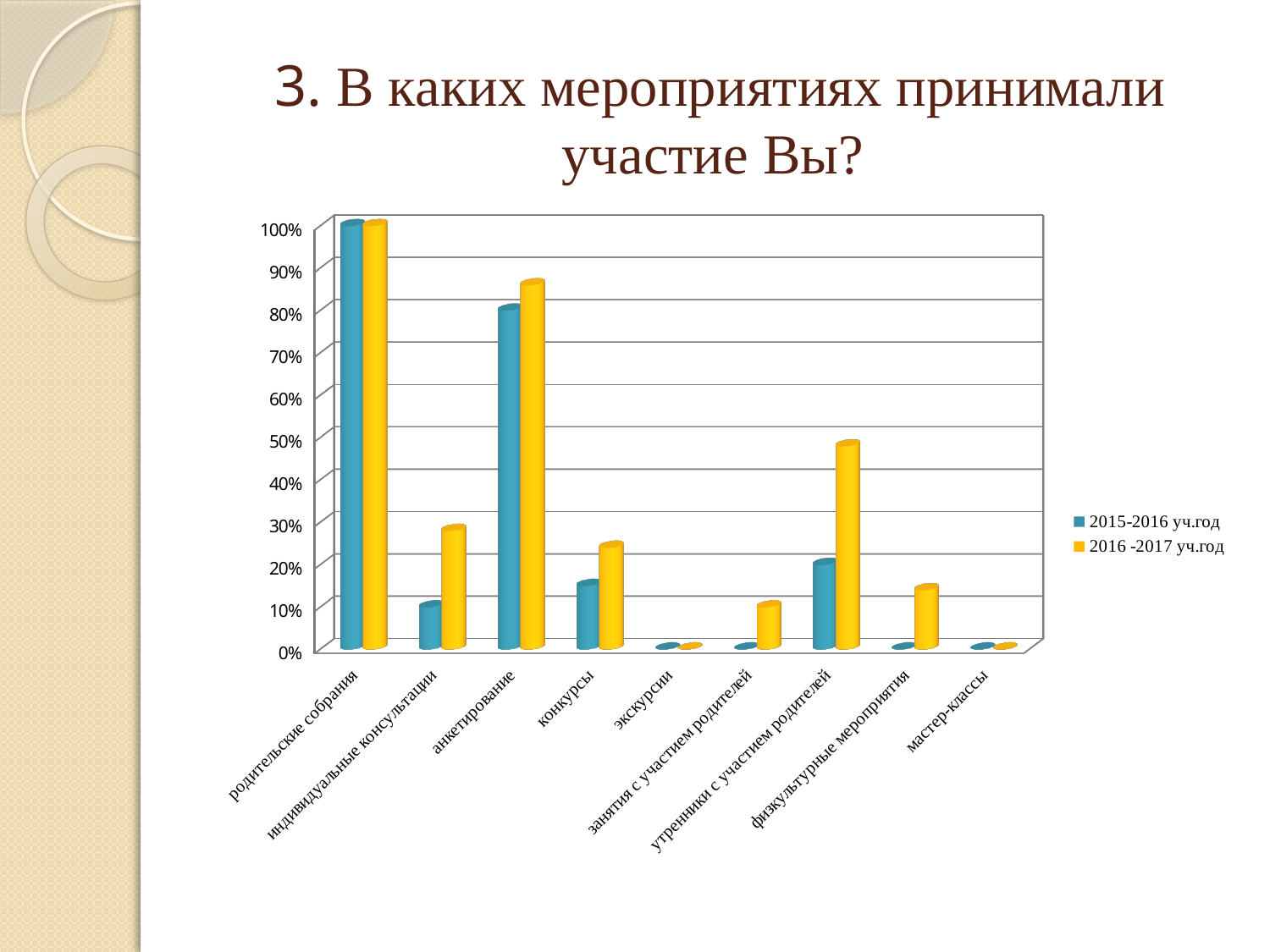
Is the value for анкетирование in the 2016 -2017 уч.год series greater or less than 80%? greater Is the value for утренники с участием родителей in the 2016 -2017 уч.год series greater or less than 40%? greater For утренники с участием родителей, which series has the larger value: 2015-2016 уч.год or 2016 -2017 уч.год? 2016 -2017 уч.год Which series is shown in yellow in the legend? 2016 -2017 уч.год How many series does the legend list? 2 Is the value for конкурсы in the 2016 -2017 уч.год series greater or less than 30%? less Which category has the highest value for the 2016 -2017 уч.год series? родительские собрания What kind of chart is shown on the slide? bar chart How many categories are shown on the x axis? 9 In the 2016 -2017 уч.год series, which is larger: анкетирование or утренники с участием родителей? анкетирование